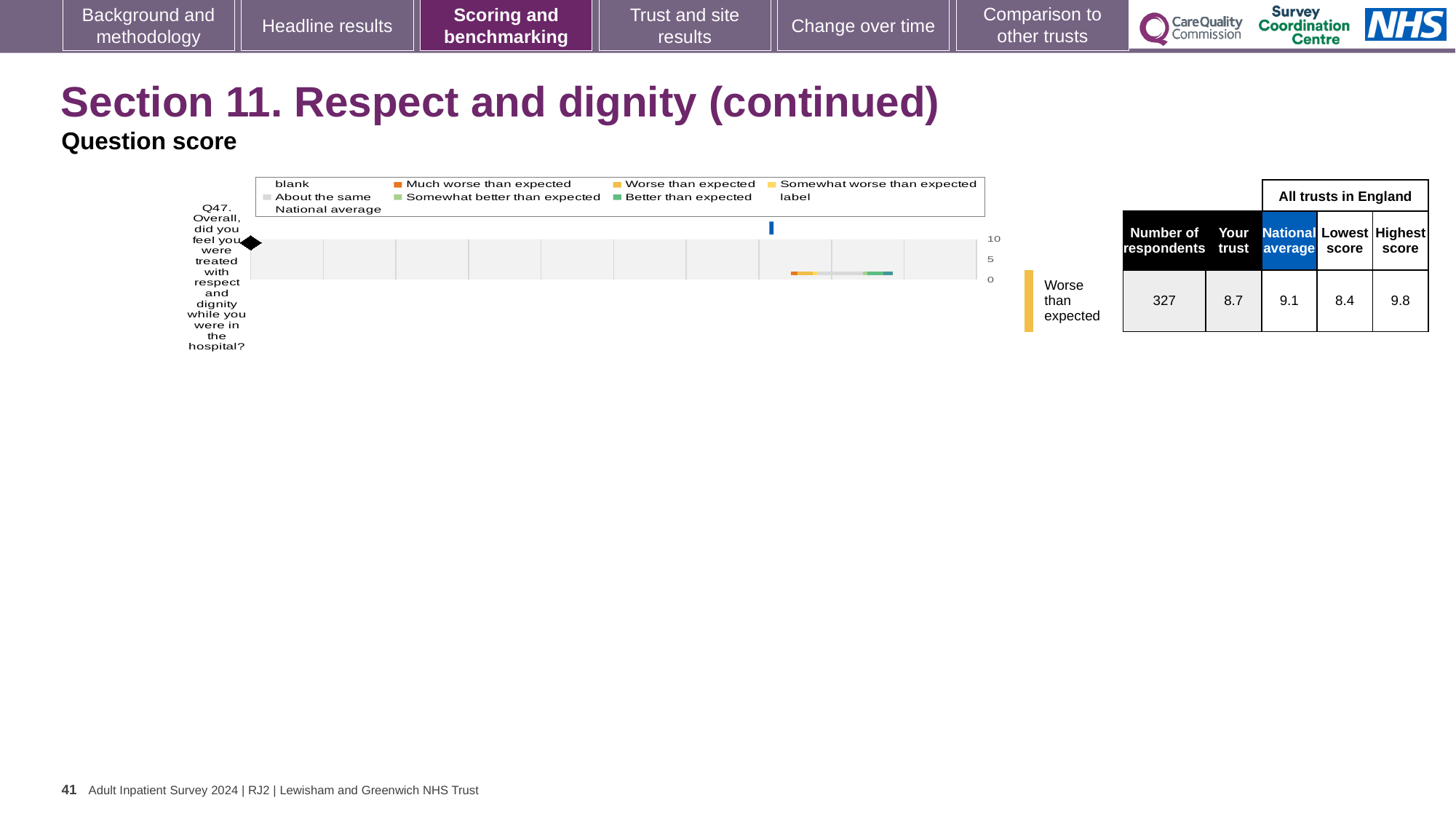
According to the table beside the chart, what is the national average for Q47? 9.1 Is the 'Your trust' score for Q47 larger or smaller than the national average? smaller According to the table beside the chart, what is the highest score among all trusts in England for Q47? 9.8 What is the highest value shown on the chart's axis? 10 According to the table beside the chart, what is the 'Your trust' score for Q47? 8.7 According to the table beside the chart, what is the lowest score among all trusts in England for Q47? 8.4 What benchmarking category is shown next to the chart for Q47? Worse than expected What kind of chart is shown on the slide? bar chart According to the table beside the chart, how many respondents answered Q47? 327 How many questions are plotted on the chart? 1 Which question is plotted on the chart? Q47. Overall, did you feel you were treated with respect and dignity while you were in the hospital? What is the difference between the national average and the 'Your trust' score for Q47? 0.4